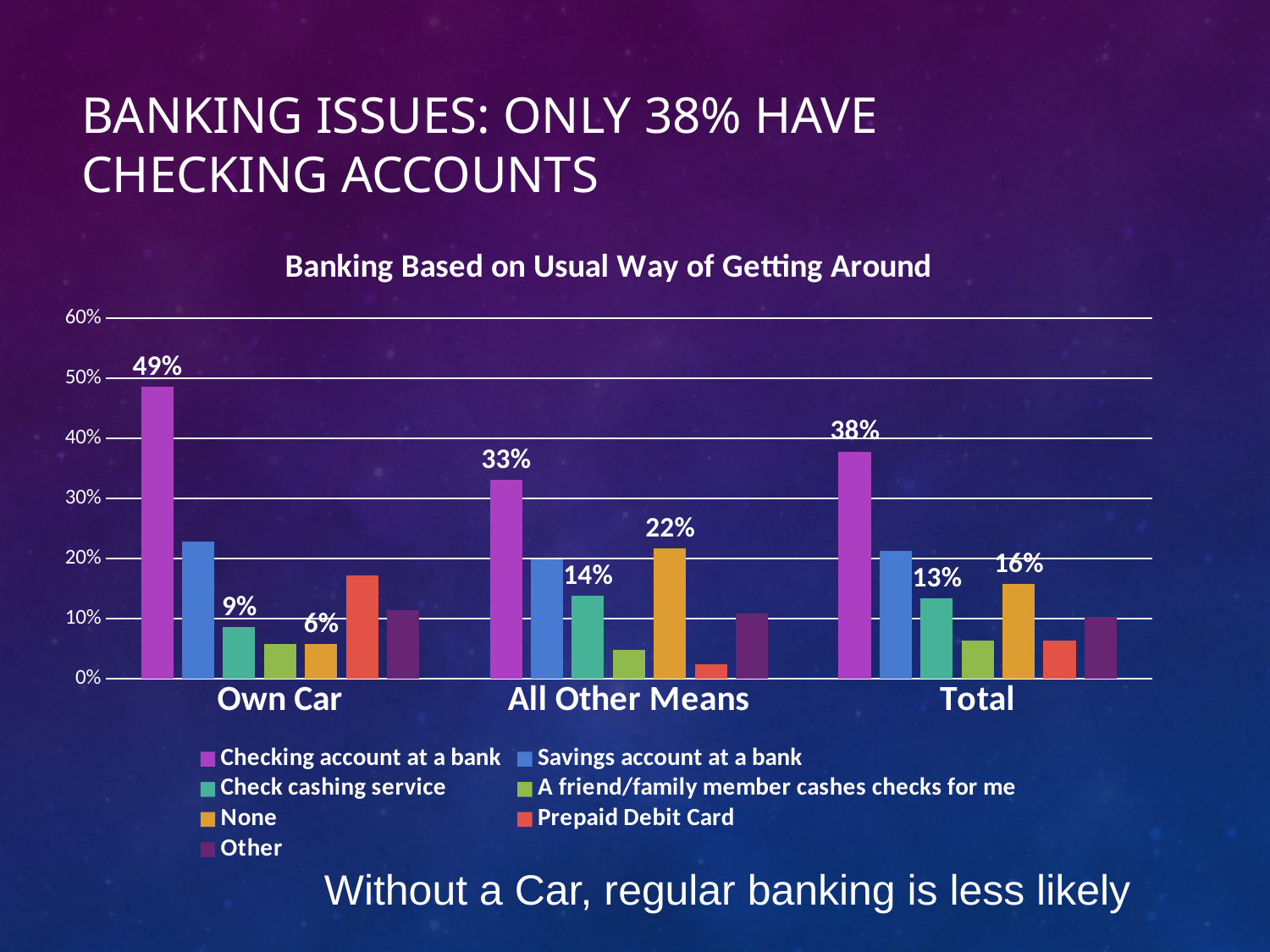
Is the value for Prepaid Debit Card in the All Other Means category greater or less than 10%? less What type of chart is shown on the slide? Bar chart Which category has the highest value for Checking account at a bank? Own Car Is the value for Savings account at a bank in the Own Car category greater or less than 20%? greater Which category has the larger value for None: Own Car or All Other Means? All Other Means What is the value for Checking account at a bank in the Own Car category? 49% What is the value for Check cashing service in the Total category? 13% What is the difference between the Checking account at a bank values for Own Car and All Other Means? 16 percentage points What is the value for None in the All Other Means category? 22% What is the value for Checking account at a bank in the All Other Means category? 33% How many categories are shown on the x axis? 3 How many series does the legend list? 7